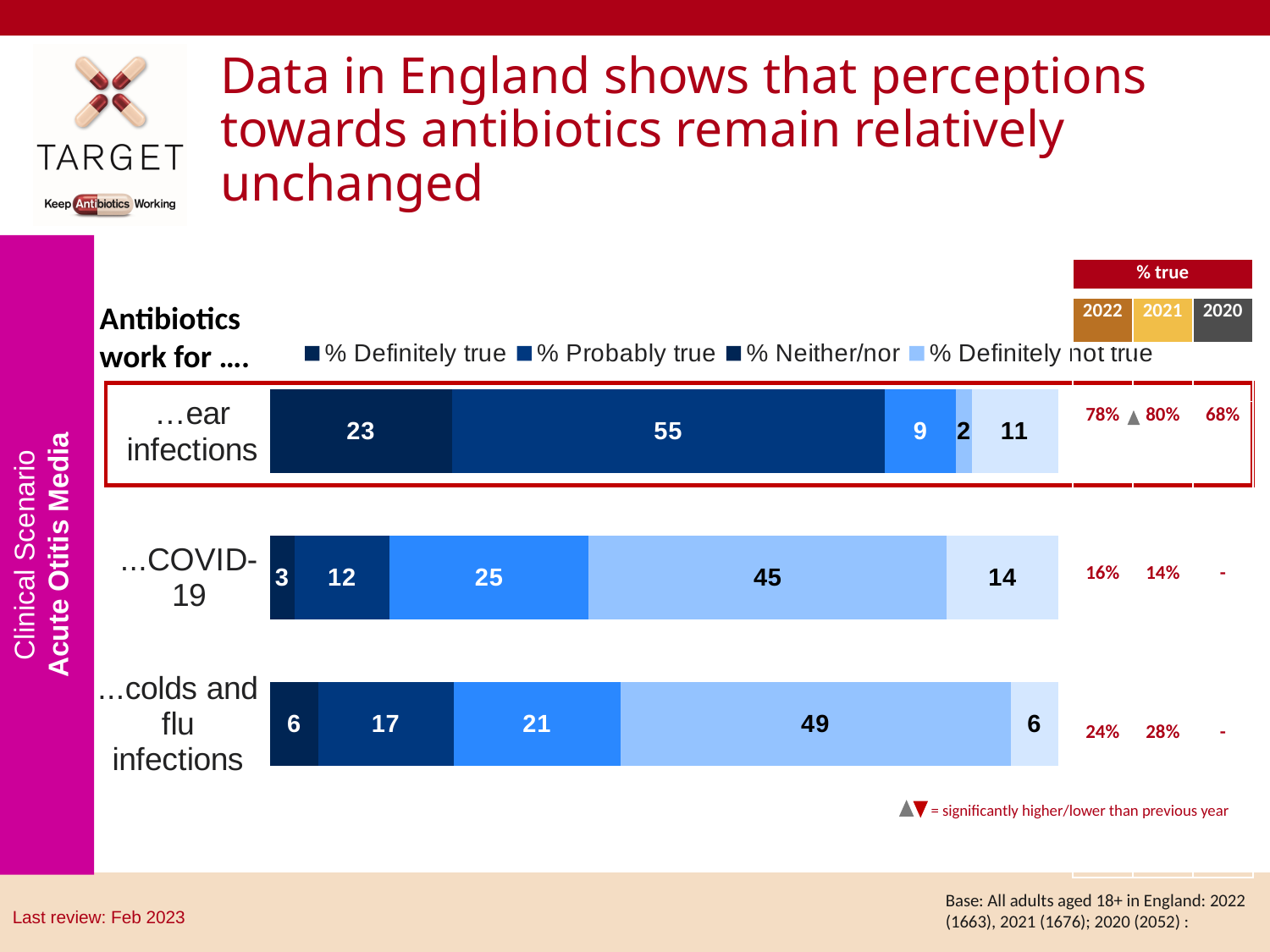
What is the % Definitely not true value for colds and flu infections? 49 Which category has the lowest % Definitely true value? COVID-19 What is the difference between the % Probably true values for ear infections and colds and flu infections? 38 What is the total of the stacked bar for ear infections? 100 What is the % Definitely true value for ear infections? 23 Which category has the highest % Definitely true value? ear infections In the % true table, what is the 2022 value for ear infections? 78% What is the % Probably true value for ear infections? 55 How many categories are shown in the chart? 3 What kind of chart is shown on the slide? stacked bar chart